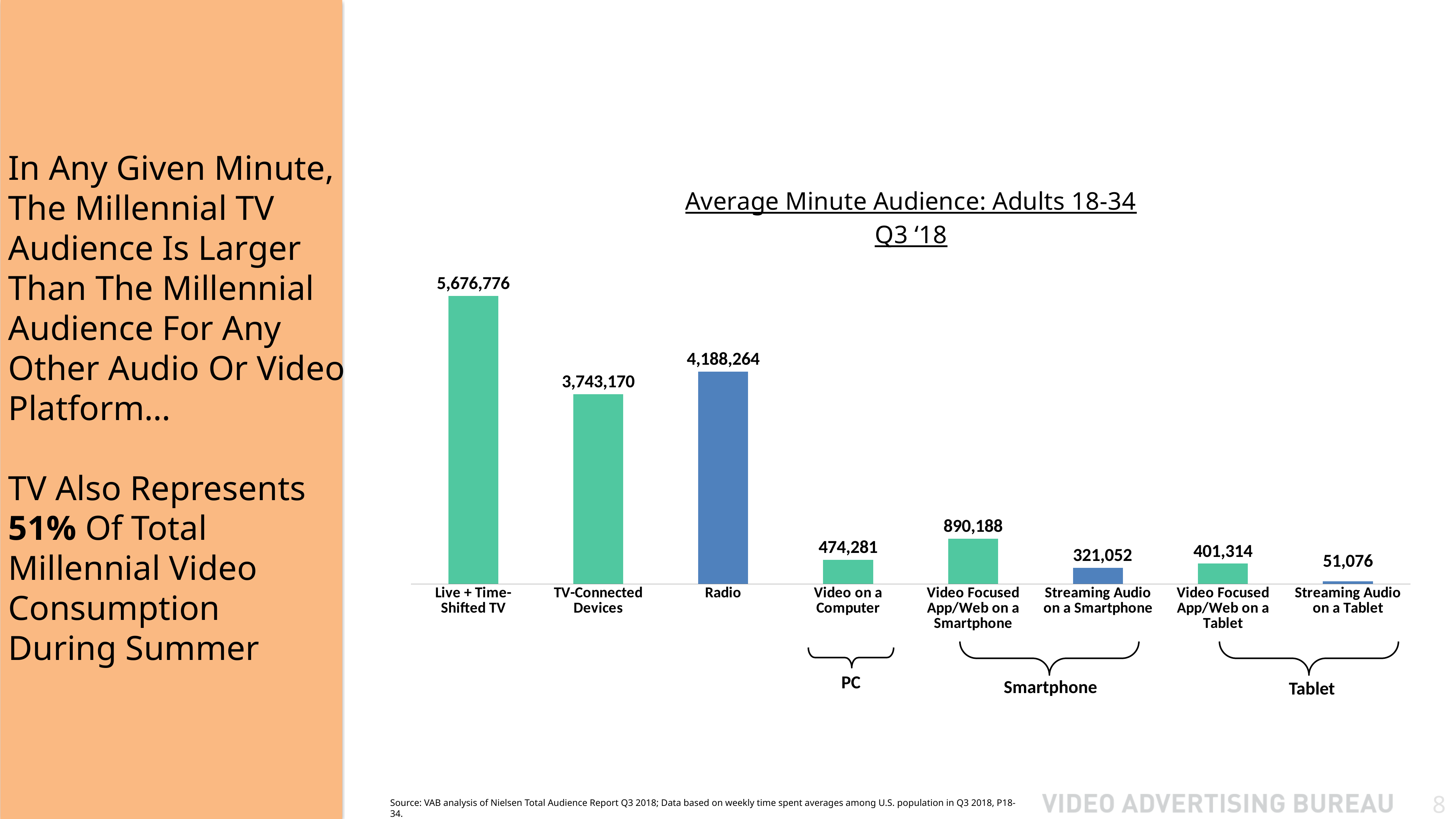
Which is larger: the value for Video Focused App/Web on a Tablet or Streaming Audio on a Smartphone? Video Focused App/Web on a Tablet Which category has the lowest average minute audience? Streaming Audio on a Tablet What is the title of the chart? Average Minute Audience: Adults 18-34 Q3 '18 Which category has the highest average minute audience? Live + Time-Shifted TV What is the value shown for Streaming Audio on a Tablet? 51,076 How many categories are shown in the chart? 8 What kind of chart is shown on the slide? Bar chart What is the average minute audience for Live + Time-Shifted TV? 5,676,776 What is the average minute audience for Radio? 4,188,264 What is the value shown for Video Focused App/Web on a Smartphone? 890,188 What is the difference between the values for Live + Time-Shifted TV and TV-Connected Devices? 1,933,606 What is the difference between the values for Radio and Video on a Computer? 3,713,983